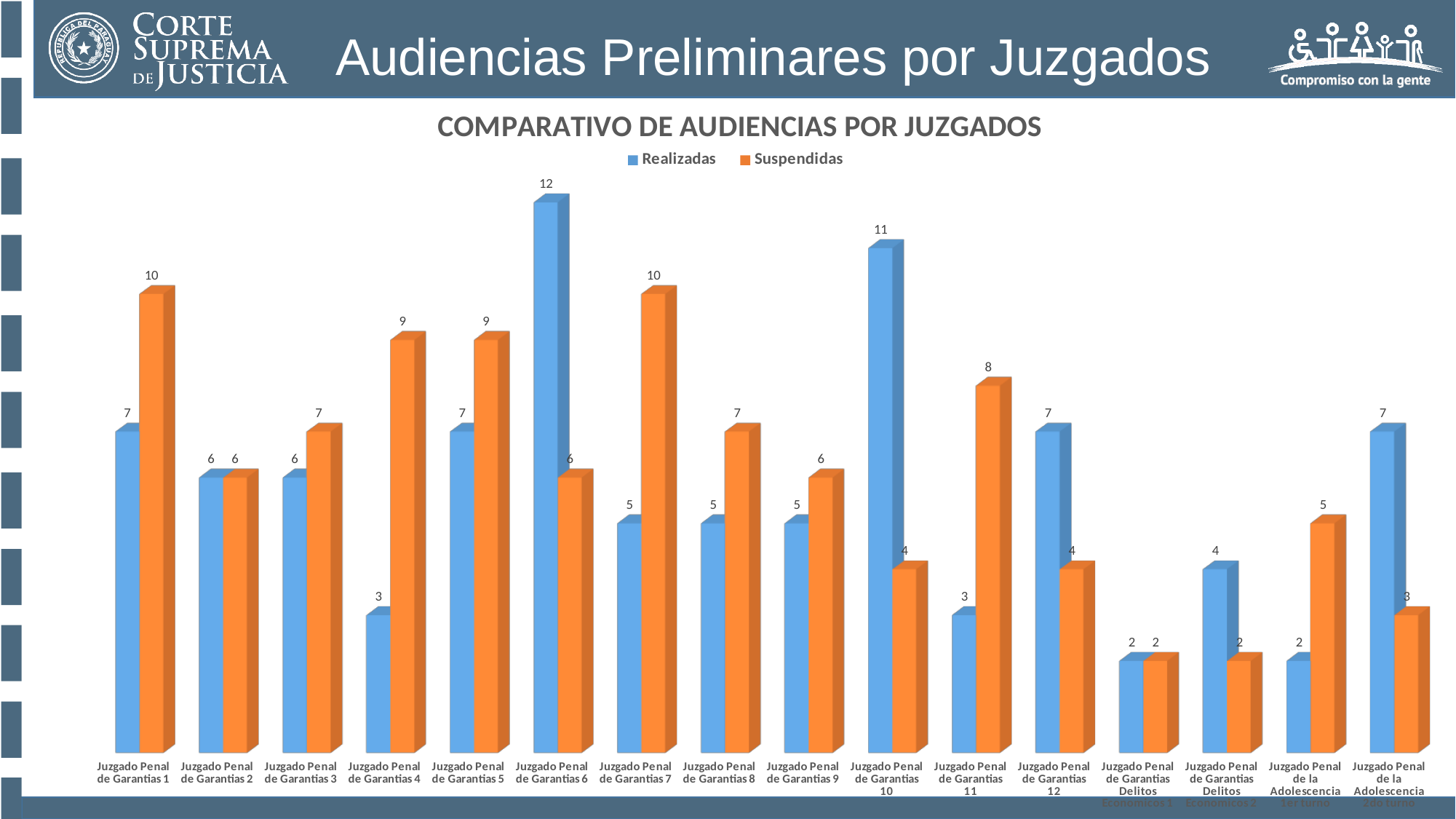
What is the Realizadas value for Juzgado Penal de Garantias 10? 11 What is the Realizadas value for Juzgado Penal de Garantias 6? 12 Which series is shown in orange? Suspendidas Which juzgado has the highest Realizadas value? Juzgado Penal de Garantias 6 What is the Suspendidas value for Juzgado Penal de Garantias 11? 8 How many series does the legend list? 2 What type of chart is shown on the slide? Bar chart For Juzgado Penal de Garantias 7, which is larger, Realizadas or Suspendidas? Suspendidas What is the title of the chart? COMPARATIVO DE AUDIENCIAS POR JUZGADOS What is the difference between Suspendidas and Realizadas for Juzgado Penal de Garantias 4? 6 What is the Suspendidas value for Juzgado Penal de Garantias 1? 10 What is the total of Realizadas and Suspendidas for Juzgado Penal de Garantias 12? 11